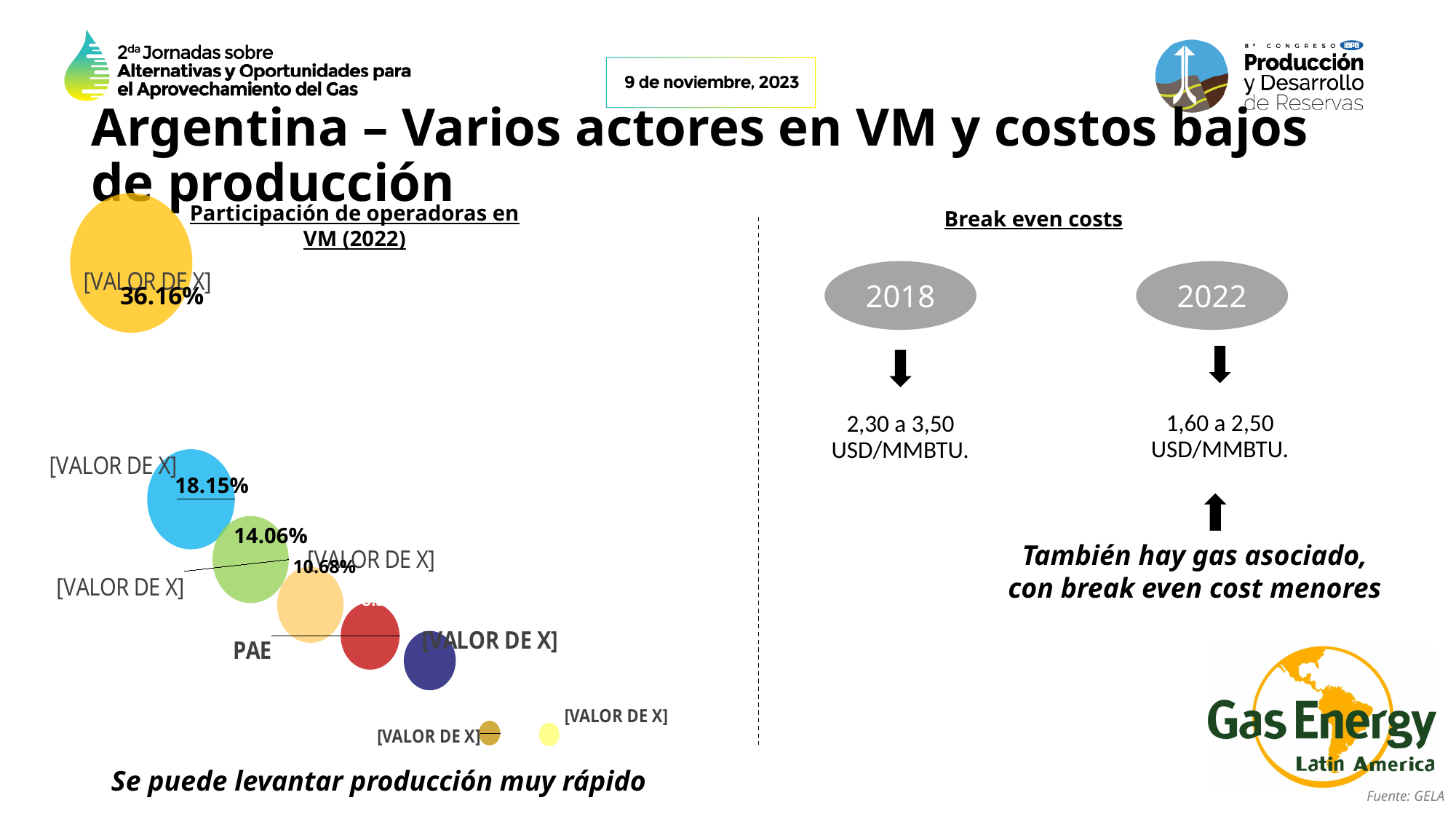
What kind of chart is shown under the title "Participación de operadoras en VM (2022)"? bubble chart In the "Participación de operadoras en VM (2022)" chart, do the bubble sizes increase or decrease from left to right? decrease In the "Participación de operadoras en VM (2022)" chart, which is larger: the share labelled 14.06% or the share labelled 10.68%? 14.06% In the "Participación de operadoras en VM (2022)" chart, what is the difference between the 18.15% share and the 14.06% share? 4.09 percentage points In the "Participación de operadoras en VM (2022)" chart, what colour is the largest bubble (36.16%)? yellow In the "Participación de operadoras en VM (2022)" chart, what is the second-largest share value printed? 18.15% In the "Participación de operadoras en VM (2022)" chart, what is the smallest share value that is printed as a number? 10.68% What is the title of the chart on the left side of the slide? Participación de operadoras en VM (2022) In the "Participación de operadoras en VM (2022)" chart, what is the difference between the largest printed share (36.16%) and the second-largest (18.15%)? 18.01 percentage points How many bubbles are plotted in the "Participación de operadoras en VM (2022)" chart? 8 In the "Participación de operadoras en VM (2022)" chart, what is the largest share value printed? 36.16%